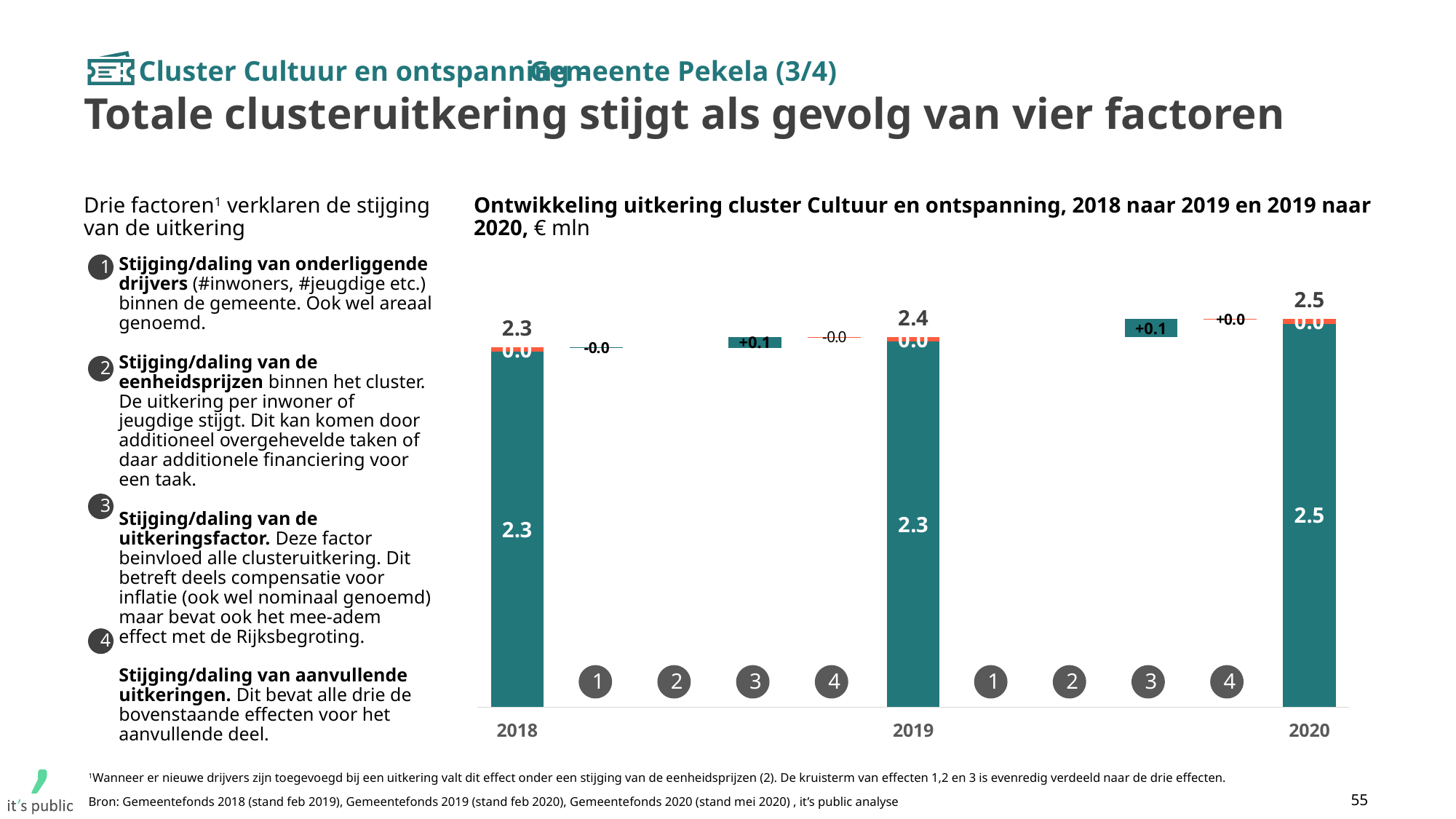
What is the value of factor 4 between 2019 and 2020? +0.0 What is the value of factor 3 between 2018 and 2019? +0.1 How many years are shown with a total bar on the chart? 3 Which year has the highest total uitkering? 2020 What is the total uitkering shown for 2019? 2.4 What is the difference between the total for 2020 and the total for 2018? 0.2 Do the total values rise or fall from 2018 to 2020? rise What is the total uitkering shown for 2020? 2.5 Which year has the lowest total uitkering? 2018 What is the total uitkering shown for 2018? 2.3 What is the value of factor 3 between 2019 and 2020? +0.1 In what unit are the values on the chart expressed? € mln